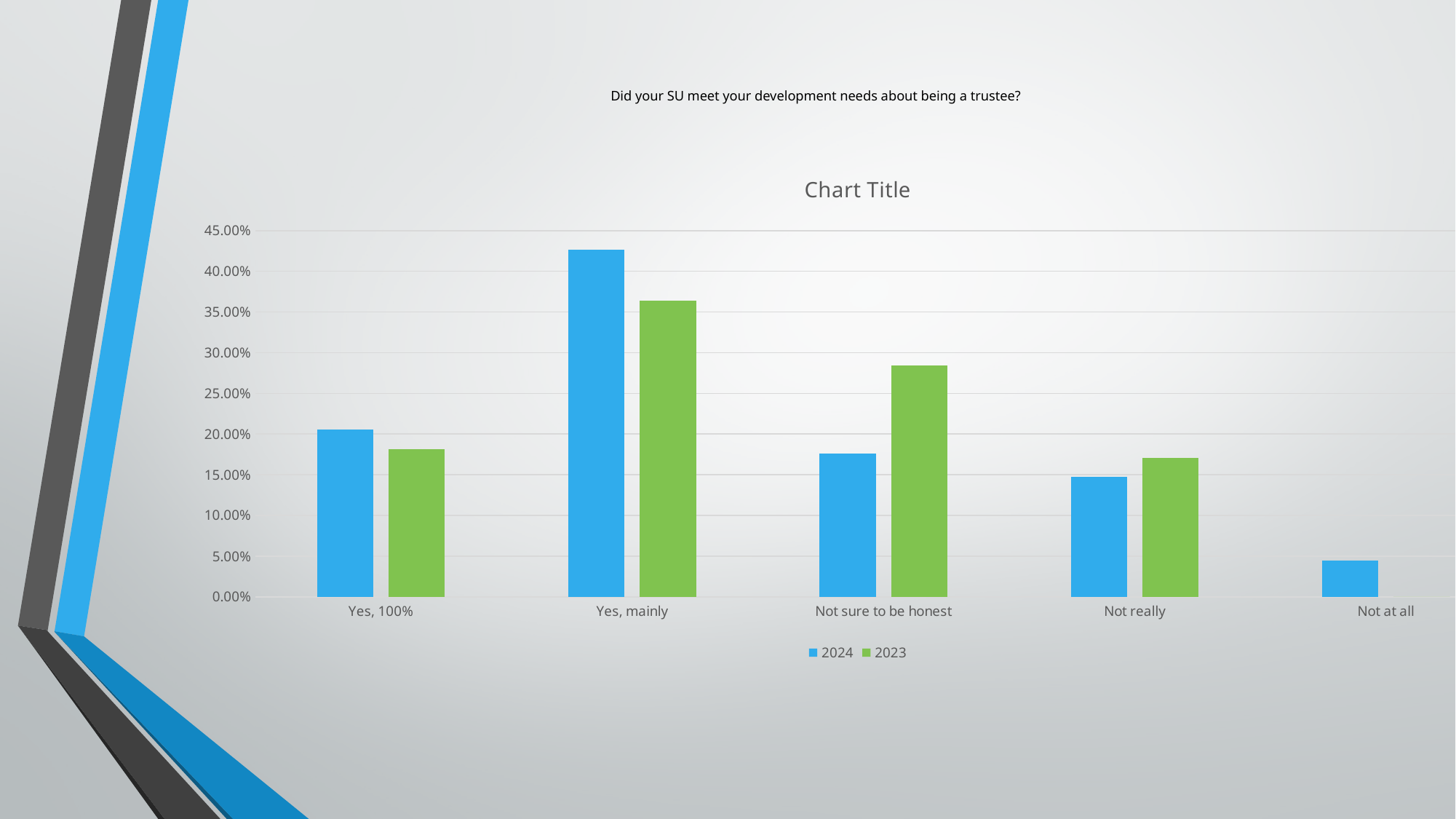
Which category has the highest value for the 2023 series? Yes, mainly Which category has the lowest value for the 2024 series? Not at all How many series does the legend list? 2 What kind of chart is shown on the slide? bar chart For 'Not sure to be honest', which series has the larger value, 2024 or 2023? 2023 Is the 2024 value for 'Yes, mainly' greater or less than 40.00%? greater What are the two entries listed in the chart legend? 2024 and 2023 For 'Yes, 100%', which series has the larger value, 2024 or 2023? 2024 How many response categories are shown on the x axis? 5 Which category has the highest value for the 2024 series? Yes, mainly Is the 2024 value for 'Not at all' greater or less than 5.00%? less Is the 2023 value for 'Not sure to be honest' greater or less than 25.00%? greater